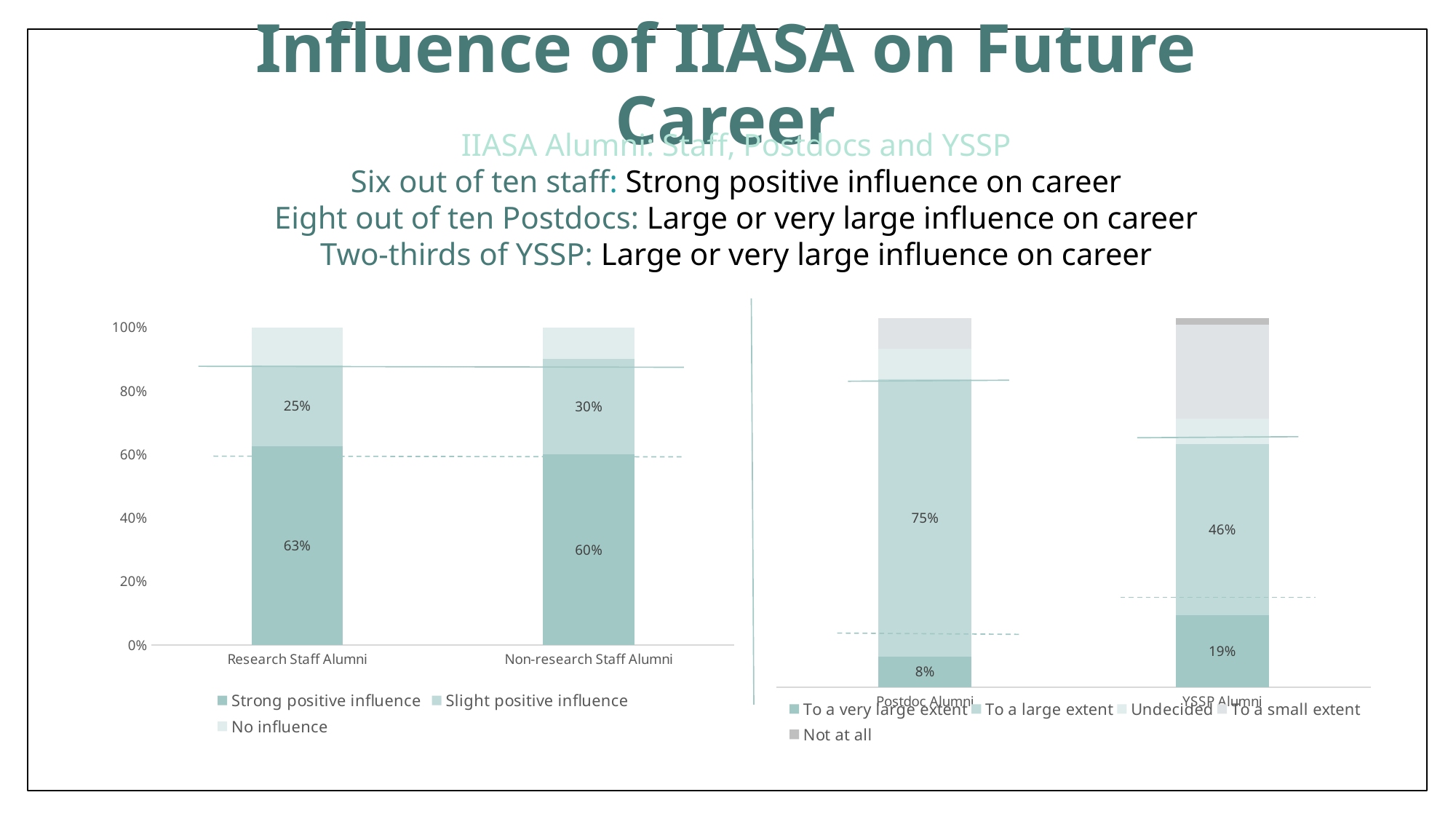
In the right chart, what is the value for To a very large extent for YSSP Alumni? 19% In the right chart, what is the difference between the To a large extent values for Postdoc Alumni and YSSP Alumni? 29% In the left chart, what is the difference between the Strong positive influence values for Research Staff Alumni and Non-research Staff Alumni? 3% In the right chart, what is the value for To a large extent for Postdoc Alumni? 75% In the right chart, how many series does the legend list? 5 In the left chart, what is the value for Strong positive influence for Research Staff Alumni? 63% In the right chart, which category has the larger To a very large extent value, Postdoc Alumni or YSSP Alumni? YSSP Alumni In the left chart, which category has the larger Slight positive influence value, Research Staff Alumni or Non-research Staff Alumni? Non-research Staff Alumni How many categories are shown on the x axis of the right chart? 2 In the left chart, how many series does the legend list? 3 In the left chart, what is the value for Slight positive influence for Non-research Staff Alumni? 30% In the left chart, what kind of chart is shown? Stacked bar chart